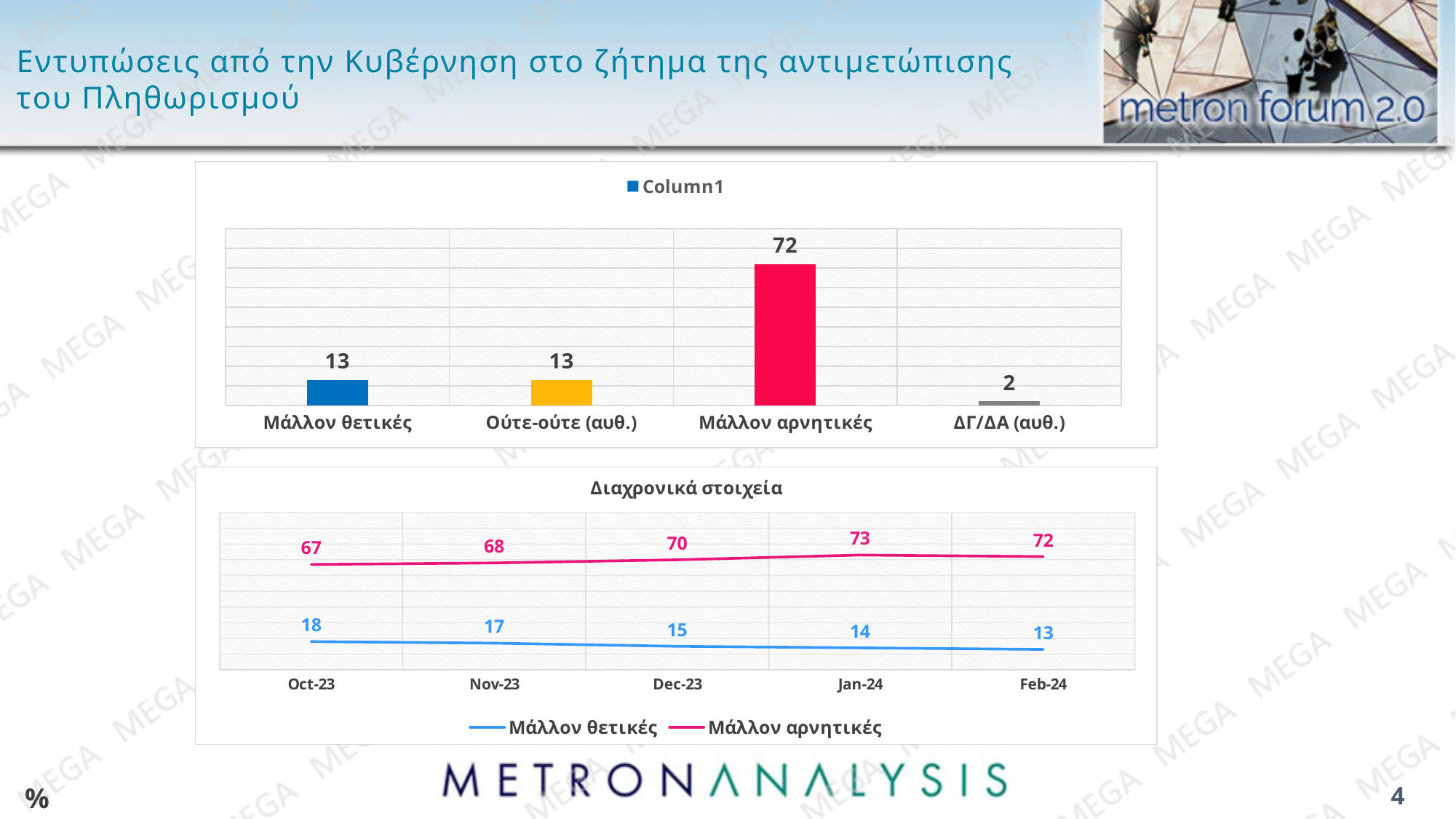
In the top bar chart, which category has the highest value? Μάλλον αρνητικές In the Διαχρονικά στοιχεία chart, does the Μάλλον θετικές series rise or fall from Oct-23 to Feb-24? Fall How many series does the legend of the Διαχρονικά στοιχεία chart list? 2 In the Διαχρονικά στοιχεία chart, what is the value for Μάλλον θετικές in Oct-23? 18 In the top bar chart, what is the value for Μάλλον αρνητικές? 72 In the Διαχρονικά στοιχεία chart, what is the value for Μάλλον αρνητικές in Jan-24? 73 In the top bar chart, what is the value for ΔΓ/ΔΑ (αυθ.)? 2 In the Διαχρονικά στοιχεία chart, what is the difference between Μάλλον αρνητικές and Μάλλον θετικές in Feb-24? 59 How many categories does the top bar chart show? 4 In the top bar chart, what is the difference between Μάλλον αρνητικές and Μάλλον θετικές? 59 What kind of chart is the top chart on the slide? Bar chart In the top bar chart, which category has the lowest value? ΔΓ/ΔΑ (αυθ.)